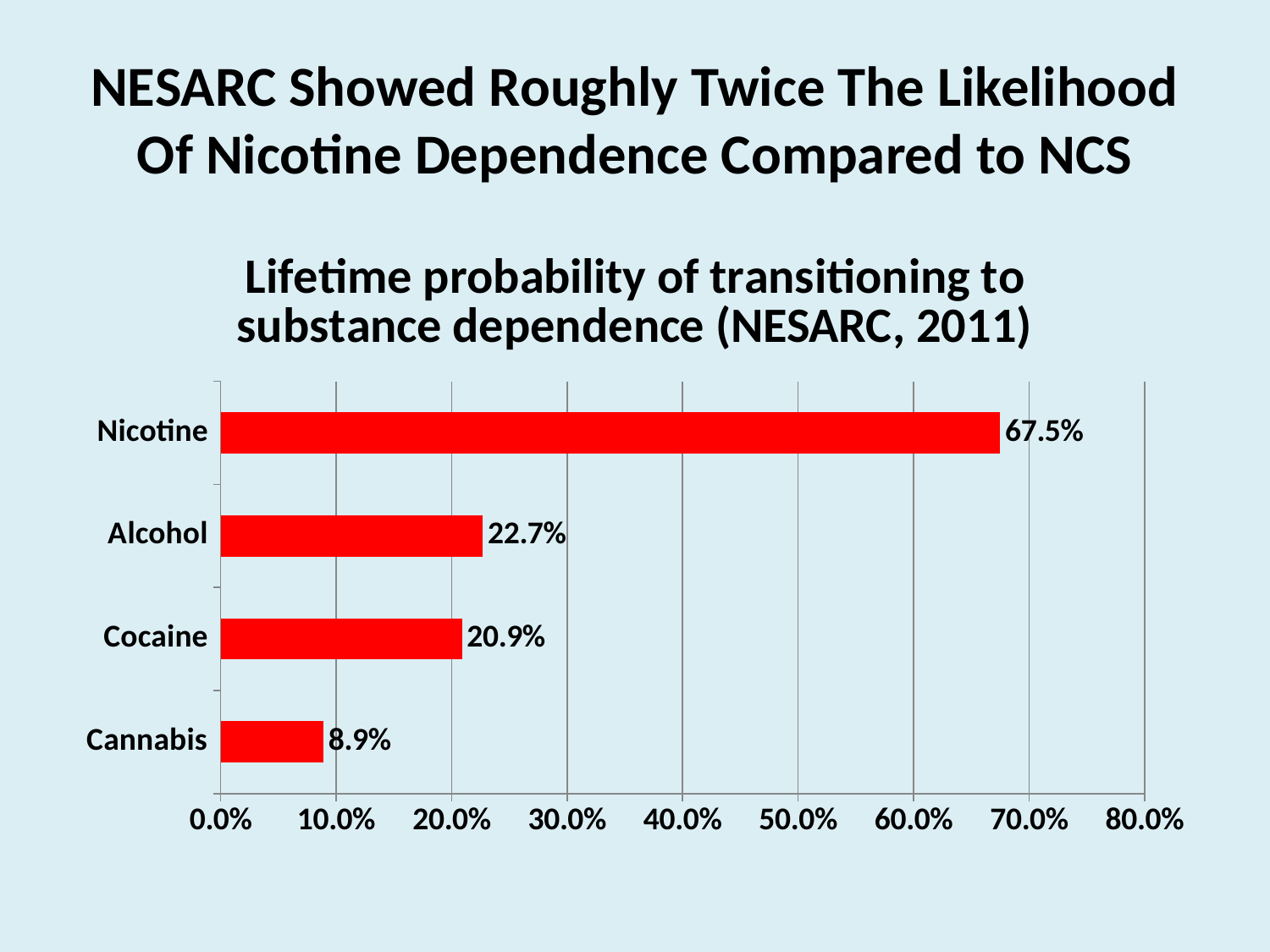
What is the difference between the values for Nicotine and Alcohol? 44.8% What is the lifetime probability of transitioning to dependence for Alcohol? 22.7% How many substances are shown in the chart? 4 Is the value for Nicotine greater or less than 60.0%? greater Which substance has the highest lifetime probability of transitioning to dependence? Nicotine What is the difference between the values for Cocaine and Cannabis? 12.0% What is the lifetime probability of transitioning to dependence for Cannabis? 8.9% Which has a higher lifetime probability of dependence, Alcohol or Cocaine? Alcohol What type of chart is shown on the slide? Bar chart Which substance has the lowest lifetime probability of transitioning to dependence? Cannabis What is the lifetime probability of transitioning to dependence for Cocaine? 20.9% What is the lifetime probability of transitioning to dependence for Nicotine? 67.5%